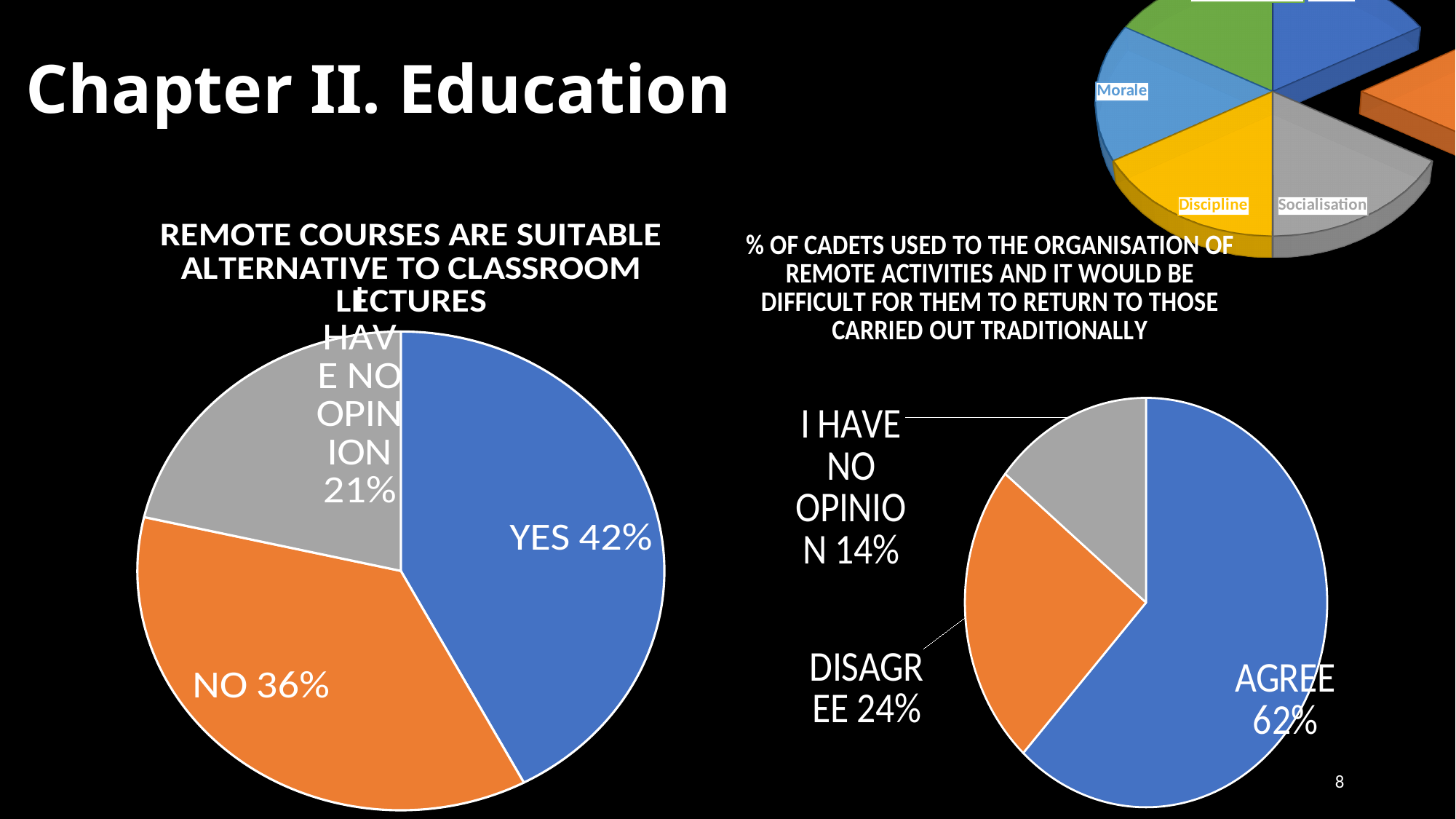
On the left chart titled 'Remote courses are suitable alternative to classroom lectures', what percentage answered YES? 42% On the right chart about cadets used to the organisation of remote activities, which response has the smallest slice? I HAVE NO OPINION On the left chart titled 'Remote courses are suitable alternative to classroom lectures', what is the difference between the YES and NO percentages? 6% On the right chart about cadets used to the organisation of remote activities, what percentage chose AGREE? 62% On the right chart about cadets used to the organisation of remote activities, what is the difference between AGREE and DISAGREE? 38% On the left chart titled 'Remote courses are suitable alternative to classroom lectures', what percentage answered NO? 36% On the right chart about cadets used to the organisation of remote activities, which is larger: DISAGREE or I HAVE NO OPINION? DISAGREE On the right chart about cadets used to the organisation of remote activities, what percentage chose DISAGREE? 24% On the left chart titled 'Remote courses are suitable alternative to classroom lectures', which response has the largest slice? YES On the left chart titled 'Remote courses are suitable alternative to classroom lectures', how many slices does the pie have? 3 What type of chart is the left chart titled 'Remote courses are suitable alternative to classroom lectures'? Pie chart On the left chart titled 'Remote courses are suitable alternative to classroom lectures', what share of respondents had no opinion? 21%